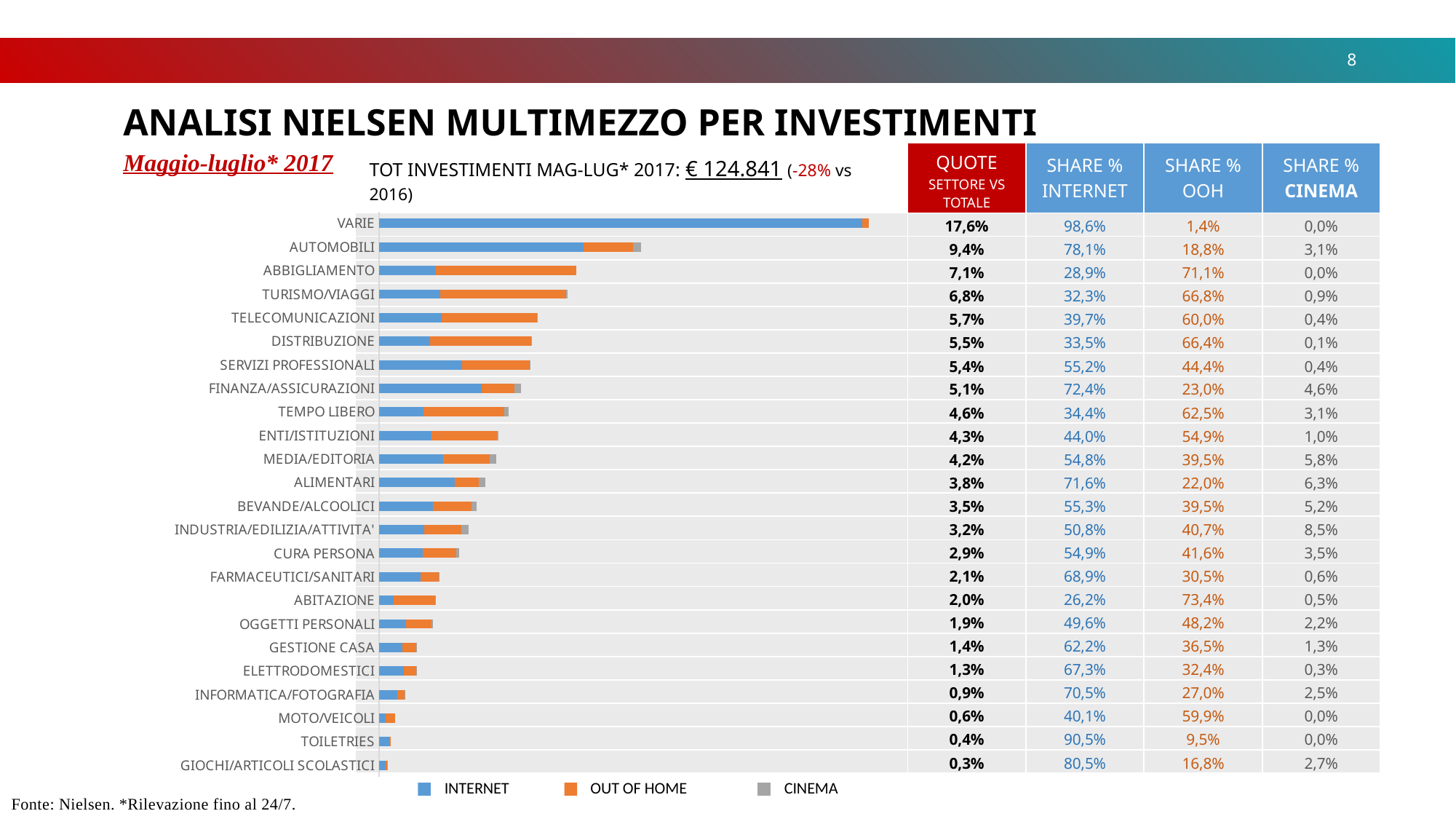
What is the SHARE % CINEMA value for INDUSTRIA/EDILIZIA/ATTIVITA'? 8,5% How many sectors (categories) are plotted in the bar chart? 24 Which sector has the longest bar in the chart? VARIE Which sector has the shortest bar in the chart? GIOCHI/ARTICOLI SCOLASTICI Which sector has the larger QUOTE SETTORE VS TOTALE, TURISMO/VIAGGI or TELECOMUNICAZIONI? TURISMO/VIAGGI Which colour represents OUT OF HOME in the chart legend? Orange What kind of chart is shown on the slide? Stacked bar chart What is the SHARE % INTERNET value for VARIE? 98,6% What is the QUOTE SETTORE VS TOTALE value for AUTOMOBILI? 9,4% How many series does the chart legend list? 3 What is the difference in QUOTE SETTORE VS TOTALE between VARIE and AUTOMOBILI? 8,2% What is the SHARE % OOH value for ABBIGLIAMENTO? 71,1%